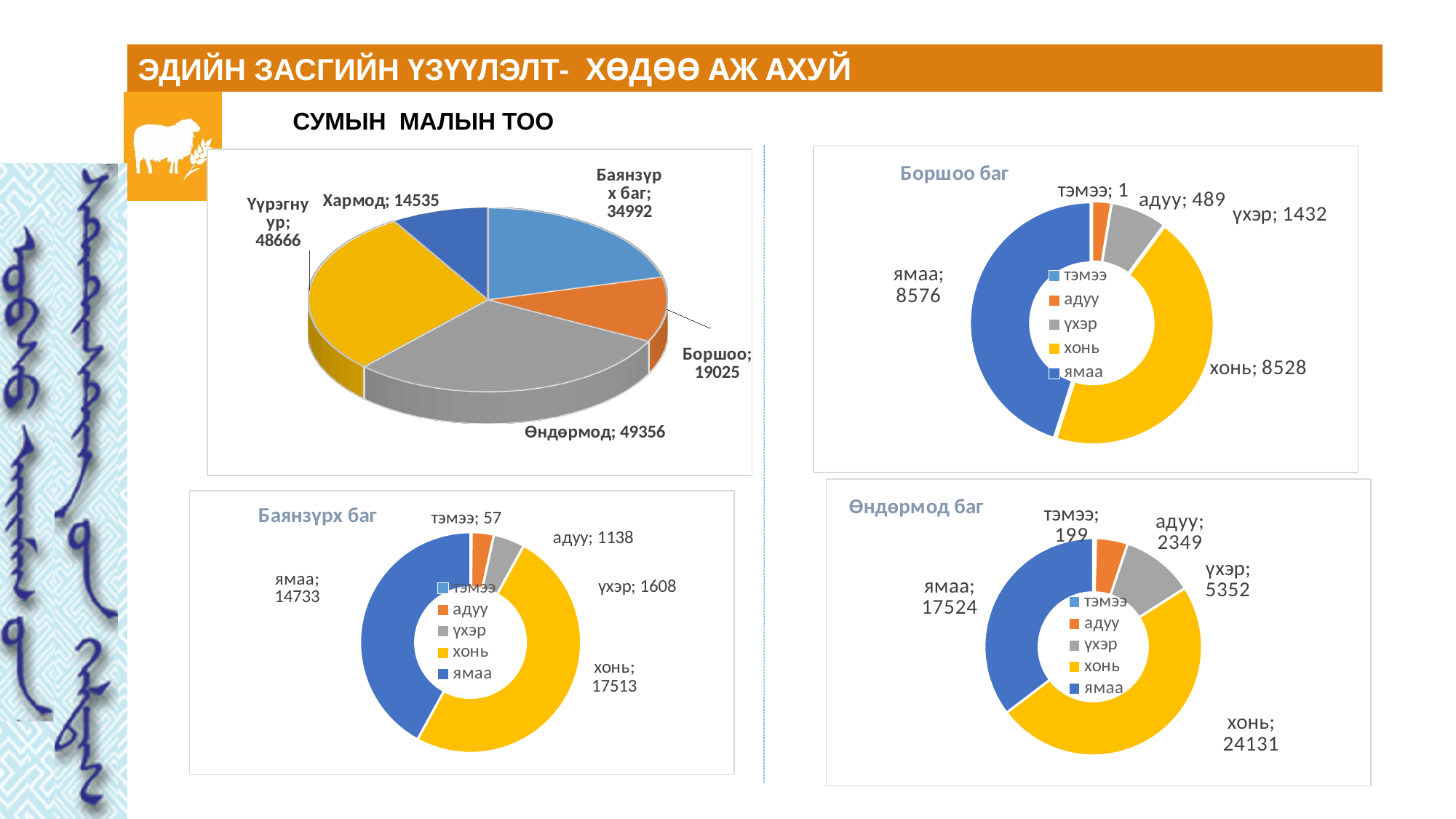
In the СУМЫН МАЛЫН ТОО pie chart, what is the value for Боршоо? 19025 In the Боршоо баг chart, what is the value for үхэр? 1432 In the СУМЫН МАЛЫН ТОО pie chart, what is the difference between Баянзүрх баг and Боршоо? 15967 In the СУМЫН МАЛЫН ТОО pie chart, what is the value for Хармод? 14535 How many categories does the СУМЫН МАЛЫН ТОО pie chart show? 5 What kind of chart is the СУМЫН МАЛЫН ТОО chart at the top left? pie chart How many entries does the legend of the Өндөрмод баг chart list? 5 In the Өндөрмод баг chart, what is the value for адуу? 2349 In the Боршоо баг chart, which category has the lowest value? тэмээ In the Баянзүрх баг chart, which category has the highest value? хонь In the Өндөрмод баг chart, which is larger, хонь or ямаа? хонь In the Баянзүрх баг chart, what is the difference between хонь and ямаа? 2780